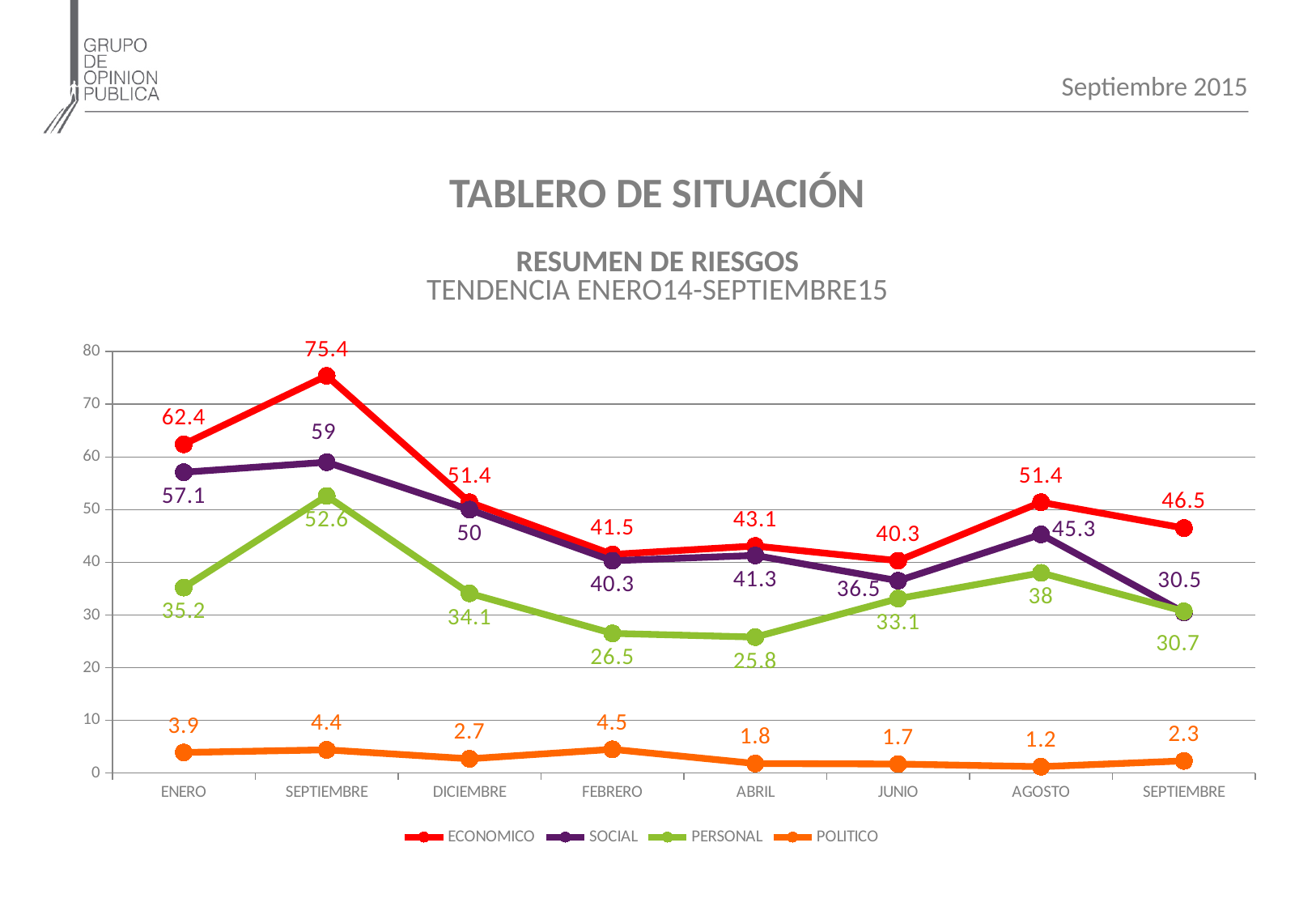
What is the value of PERSONAL in ABRIL? 25.8 At which x-axis point does ECONOMICO reach its highest value? SEPTIEMBRE (the first one) How many points are plotted along the x axis for each series? 8 What is the difference between the ECONOMICO value at the first SEPTIEMBRE and at the last SEPTIEMBRE? 28.9 What kind of chart is shown on the slide? line chart What is the difference between ECONOMICO and SOCIAL in ENERO? 5.3 In JUNIO, which is larger: SOCIAL or PERSONAL? SOCIAL How many series does the legend list? 4 What is the value of ECONOMICO in ENERO? 62.4 At which x-axis point does POLITICO reach its lowest value? AGOSTO Does the ECONOMICO line rise or fall from the first SEPTIEMBRE to FEBRERO? fall What is the value of SOCIAL in AGOSTO? 45.3